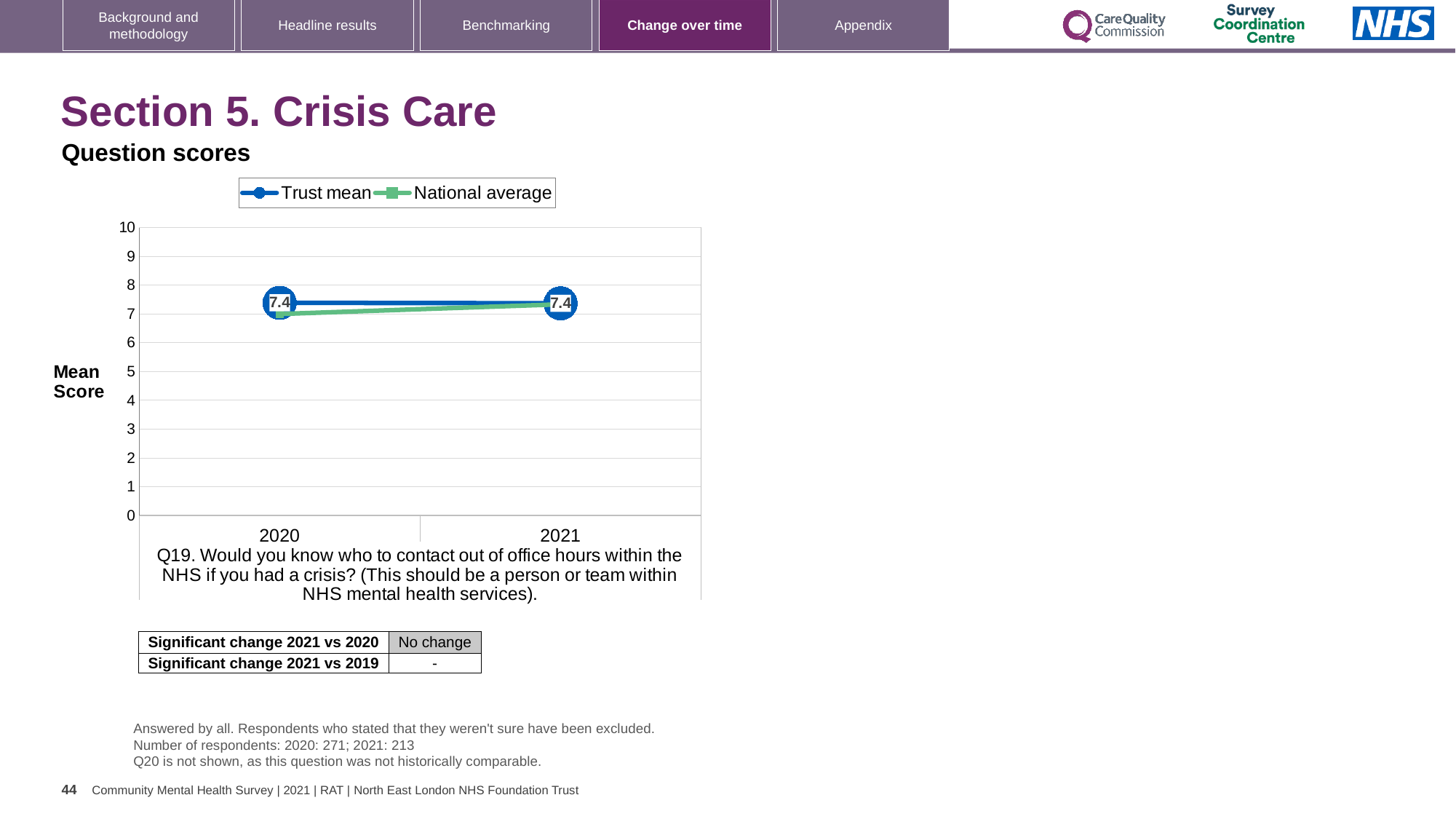
In 2020, which is higher: the Trust mean or the National average? Trust mean What type of chart is shown on the slide? Line chart How many series does the chart legend list? 2 What is the difference between the Trust mean score in 2021 and in 2020? 0 Does the National average rise or fall from 2020 to 2021? Rise Is the National average for 2020 greater or less than 8? less Does the Trust mean rise, fall or stay the same from 2020 to 2021? Stays the same What is the label of the y axis of the chart? Mean Score Is the National average for 2021 greater or less than 5? greater What is the Trust mean score for 2020? 7.4 What is the Trust mean score for 2021? 7.4 How many years are plotted on the x axis of the chart? 2